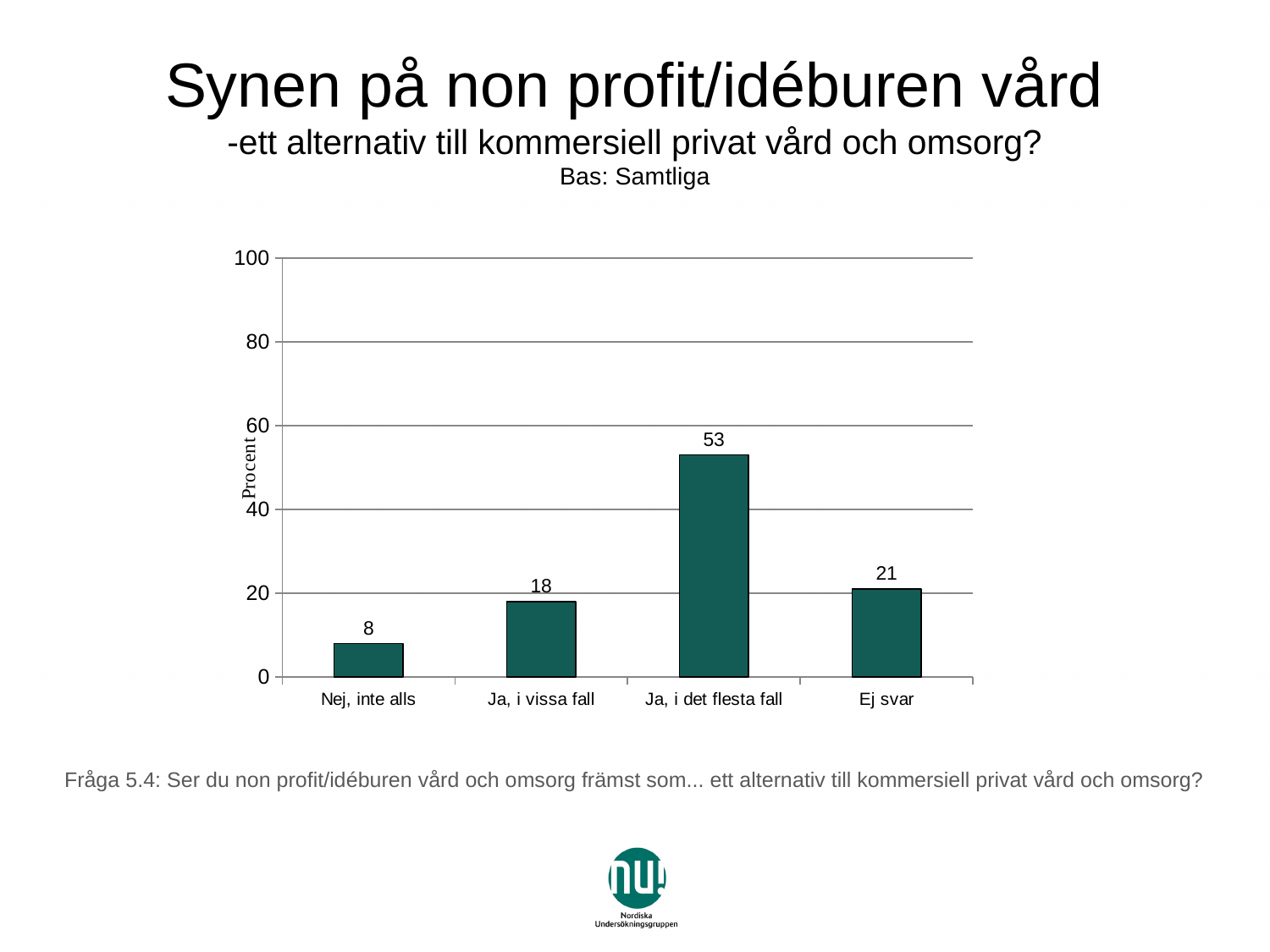
What is the value for "Nej, inte alls"? 8 What is the value for "Ja, i det flesta fall"? 53 What is the difference between the values for "Ja, i det flesta fall" and "Ej svar"? 32 What kind of chart is shown on the slide? bar chart Which category has the highest value? Ja, i det flesta fall Is the value for "Ja, i det flesta fall" greater or less than 40? greater Which is larger, the value for "Ja, i vissa fall" or the value for "Ej svar"? Ej svar Which category has the lowest value? Nej, inte alls What is the value for "Ej svar"? 21 What is the value for "Ja, i vissa fall"? 18 What is the label of the y axis? Procent How many categories are shown on the x axis? 4